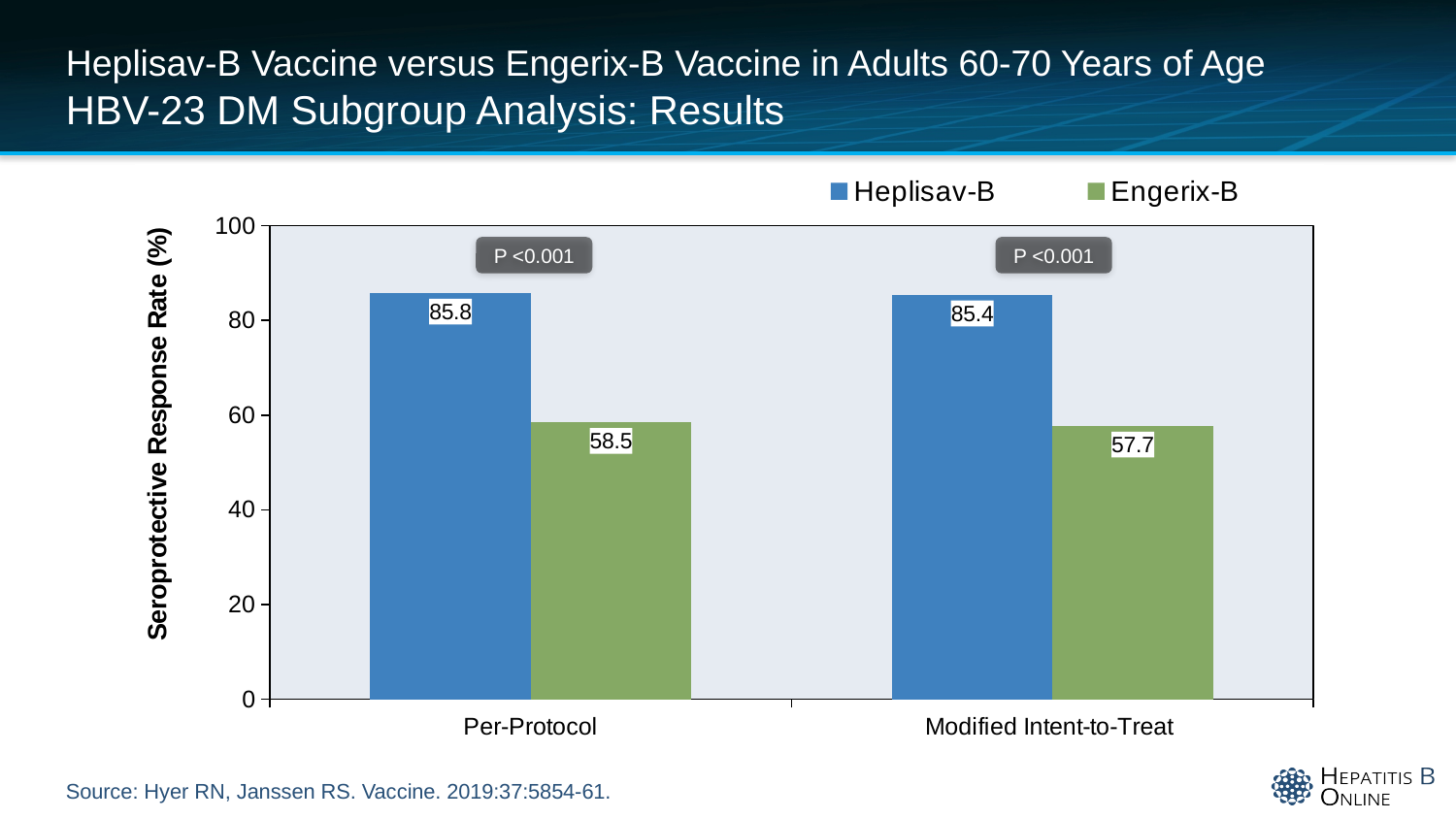
Which bar shows the highest seroprotective response rate on the chart? Heplisav-B, Per-Protocol What is the seroprotective response rate for Engerix-B in the Modified Intent-to-Treat group? 57.7 What kind of chart is shown on the slide? Bar chart How many series does the legend list? 2 How many categories are shown on the x axis? 2 What is the seroprotective response rate for Engerix-B in the Per-Protocol group? 58.5 Which vaccine has the higher seroprotective response rate in the Modified Intent-to-Treat group? Heplisav-B What is the seroprotective response rate for Heplisav-B in the Per-Protocol group? 85.8 What is the difference between the Heplisav-B and Engerix-B response rates in the Modified Intent-to-Treat group? 27.7 What is the label of the y axis? Seroprotective Response Rate (%) What is the difference between the Heplisav-B and Engerix-B response rates in the Per-Protocol group? 27.3 Which bar shows the lowest seroprotective response rate on the chart? Engerix-B, Modified Intent-to-Treat